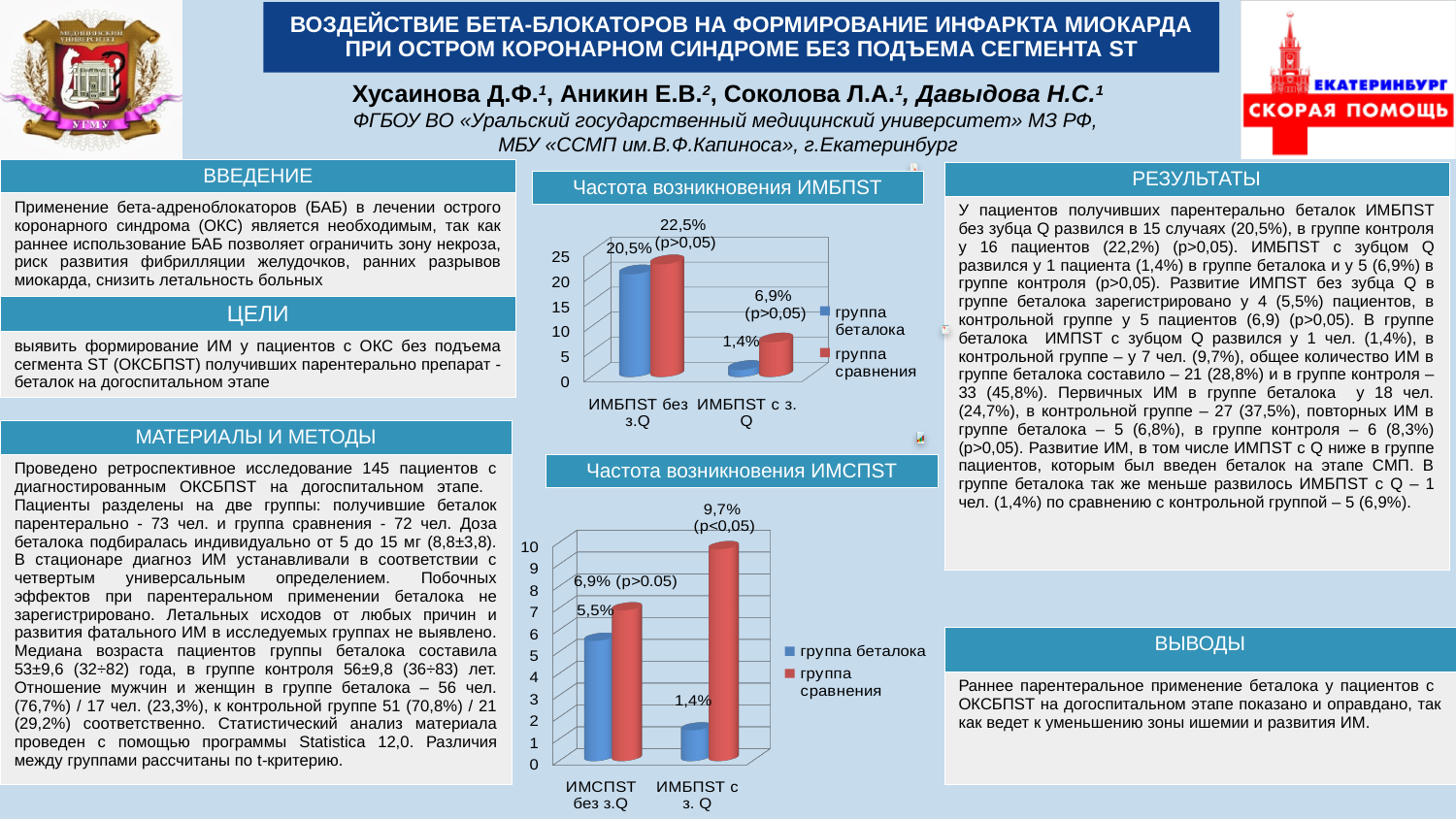
In the chart titled 'Частота возникновения ИМБПST', what is the value for 'группа беталока' in the category 'ИМБПST без з.Q'? 20,5% In the chart titled 'Частота возникновения ИМБПST', what is the value for 'группа сравнения' in the category 'ИМБПST без з.Q'? 22,5% In the chart titled 'Частота возникновения ИМСПST', what is the difference between 'группа сравнения' and 'группа беталока' in the category 'ИМСПST без з.Q'? 1,4% In the chart titled 'Частота возникновения ИМБПST', how many series does the legend list? 2 In the chart titled 'Частота возникновения ИМБПST', what is the difference between 'группа сравнения' and 'группа беталока' in the category 'ИМБПST с з. Q'? 5,5% In the chart titled 'Частота возникновения ИМСПST', which bar has the lowest value? группа беталока, ИМБПST с з. Q (1,4%) What type of chart is 'Частота возникновения ИМСПST'? bar chart In the chart titled 'Частота возникновения ИМБПST', what is the value for 'группа беталока' in the category 'ИМБПST с з. Q'? 1,4% In the chart titled 'Частота возникновения ИМСПST', what is the value for 'группа сравнения' in the category 'ИМБПST с з. Q'? 9,7% In the chart titled 'Частота возникновения ИМБПST', which group has the higher value in the category 'ИМБПST с з. Q'? группа сравнения In the chart titled 'Частота возникновения ИМСПST', how many categories are shown on the x axis? 2 In the chart titled 'Частота возникновения ИМСПST', what is the value for 'группа беталока' in the category 'ИМСПST без з.Q'? 5,5%